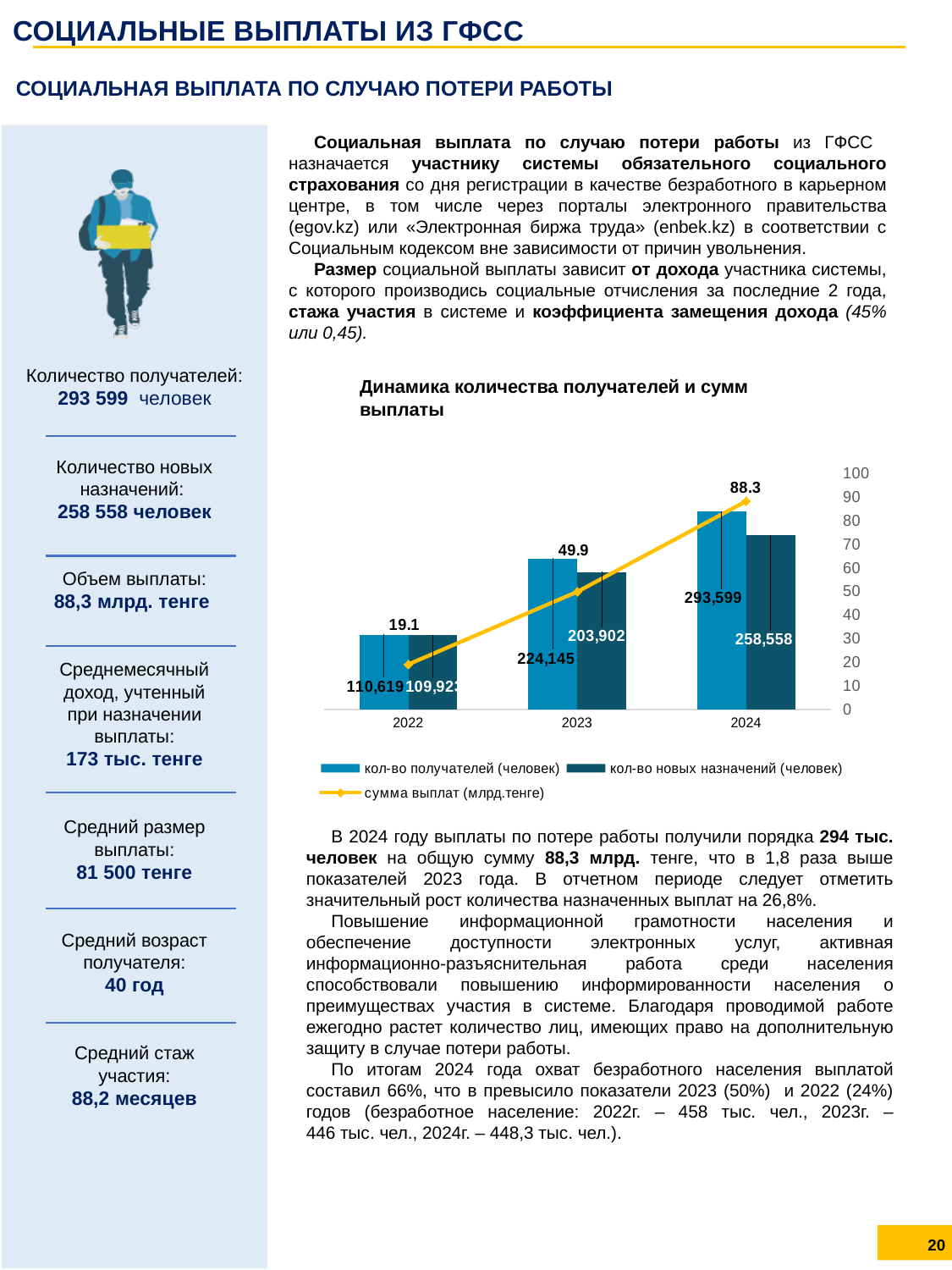
What is the value of кол-во новых назначений (человек) for 2024? 258,558 In which year is кол-во получателей (человек) the lowest? 2022 Does сумма выплат (млрд.тенге) rise or fall from 2022 to 2024? rise What is the value of сумма выплат (млрд.тенге) for 2024? 88.3 By how much did сумма выплат (млрд.тенге) increase from 2023 to 2024? 38.4 In which year is сумма выплат (млрд.тенге) the highest? 2024 How many series does the chart legend list? 3 What is the value of кол-во получателей (человек) for 2022? 110,619 What is the difference in кол-во получателей (человек) between 2024 and 2023? 69,454 In 2023, which is larger: кол-во получателей (человек) or кол-во новых назначений (человек)? кол-во получателей (человек) How many years are shown on the x axis of the chart? 3 What is the value of кол-во получателей (человек) for 2023? 224,145